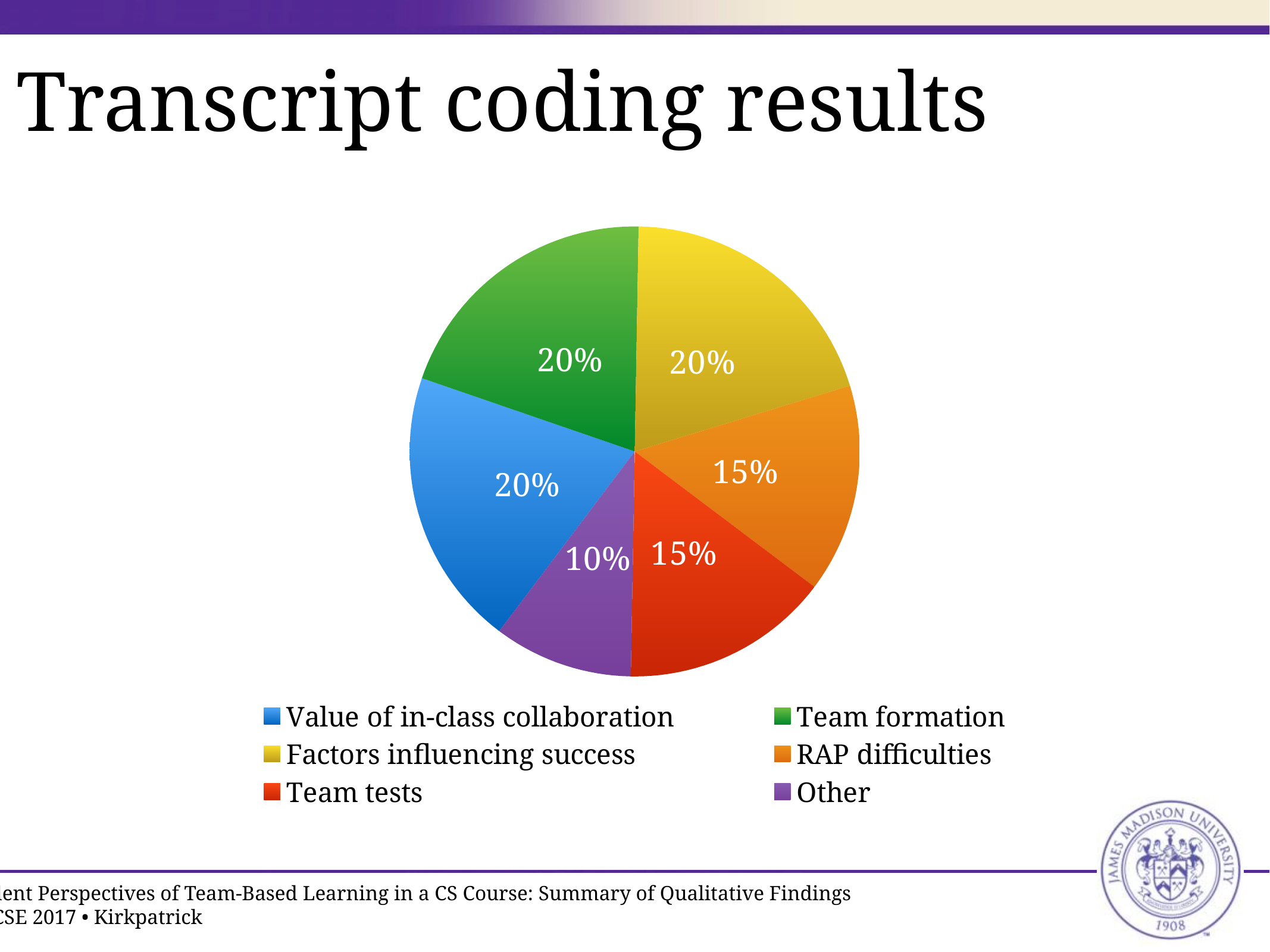
What share of the pie does Other account for? 10% What kind of chart is shown on the slide? Pie chart What colour is the slice for Factors influencing success? Yellow What percentage is shown for Team formation? 20% What percentage is shown for Team tests? 15% Which category has the smallest slice of the pie? Other Which is larger, the slice for RAP difficulties or the slice for Other? RAP difficulties What is the difference in percentage points between Value of in-class collaboration and Other? 10 What is the difference in percentage points between Factors influencing success and RAP difficulties? 5 How many categories does the pie chart have? 6 What percentage is shown for RAP difficulties? 15% Which is larger, the slice for Team formation or the slice for Team tests? Team formation